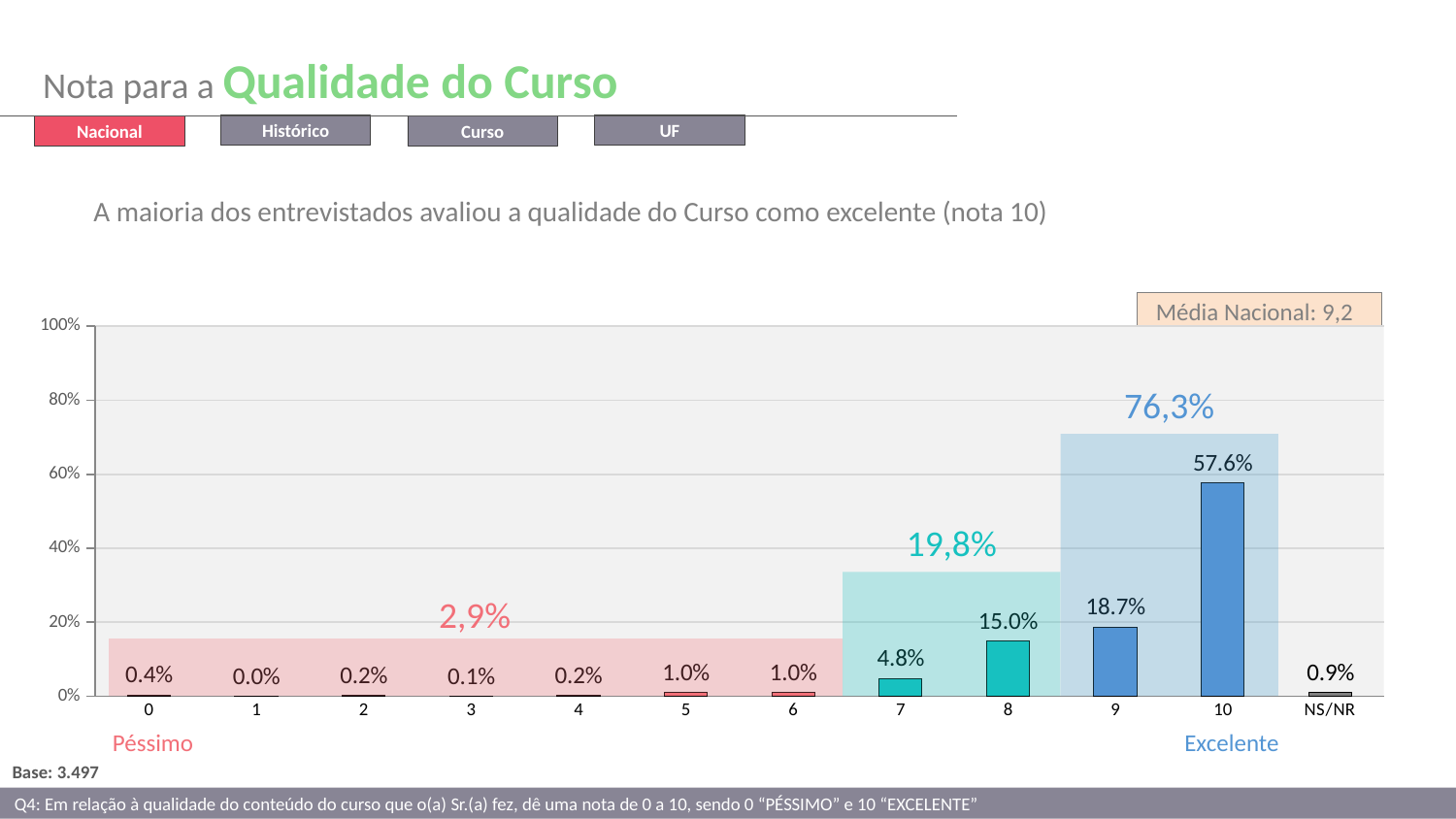
What is the combined share shown for scores 9 and 10 (the 'Excelente' group)? 76,3% What is the difference between the values for score 10 and score 9? 38.9% Which score category has the highest value? 10 How many categories are shown on the x axis? 12 What is the value for NS/NR? 0.9% Is the value for score 10 greater or less than 40%? greater Which is larger, the value for score 8 or the value for score 9? 9 Which score category has the lowest value? 1 What kind of chart is shown on the slide? bar chart What is the value for score 10? 57.6% What is the value for score 7? 4.8% What is the value for score 8? 15.0%